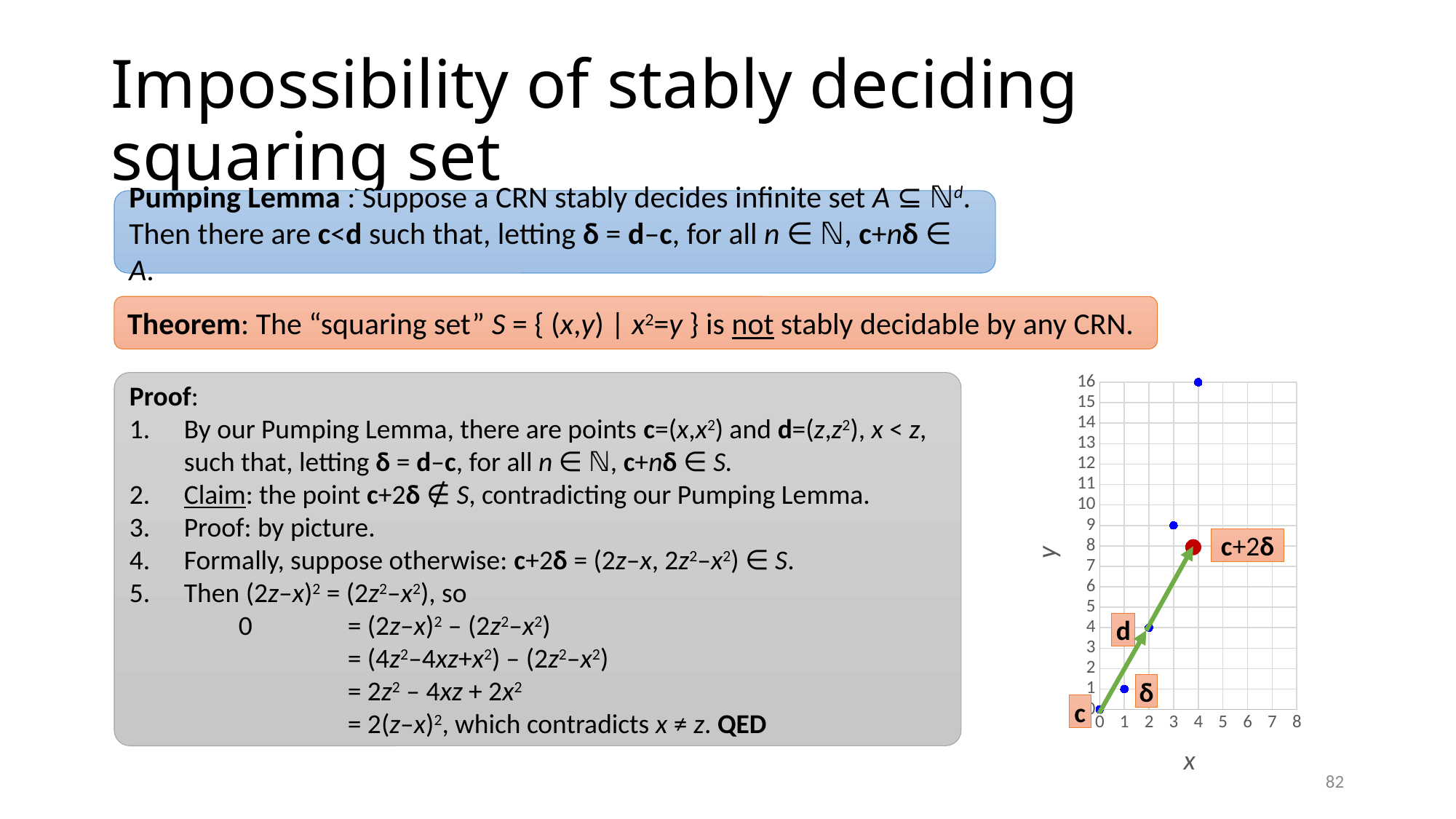
What is the difference in y between the blue point at x = 4 and the red point c+2δ? 8 What is the label of the horizontal axis of the chart? x How many blue points are plotted on the chart? 5 What is the y value of the blue point at x = 4? 16 What kind of chart is shown on the right of the slide? scatter chart Is the y value of the point labelled d greater or less than 6? less What is the y value of the red point labelled c+2δ? 8 What is the y value of the blue point at x = 3? 9 Which blue point has the highest y value? the point at x = 4 What is the label of the vertical axis of the chart? y Do the y values of the blue points rise or fall as x increases? rise Which has the larger y value: the blue point at x = 4 or the red point c+2δ? the blue point at x = 4